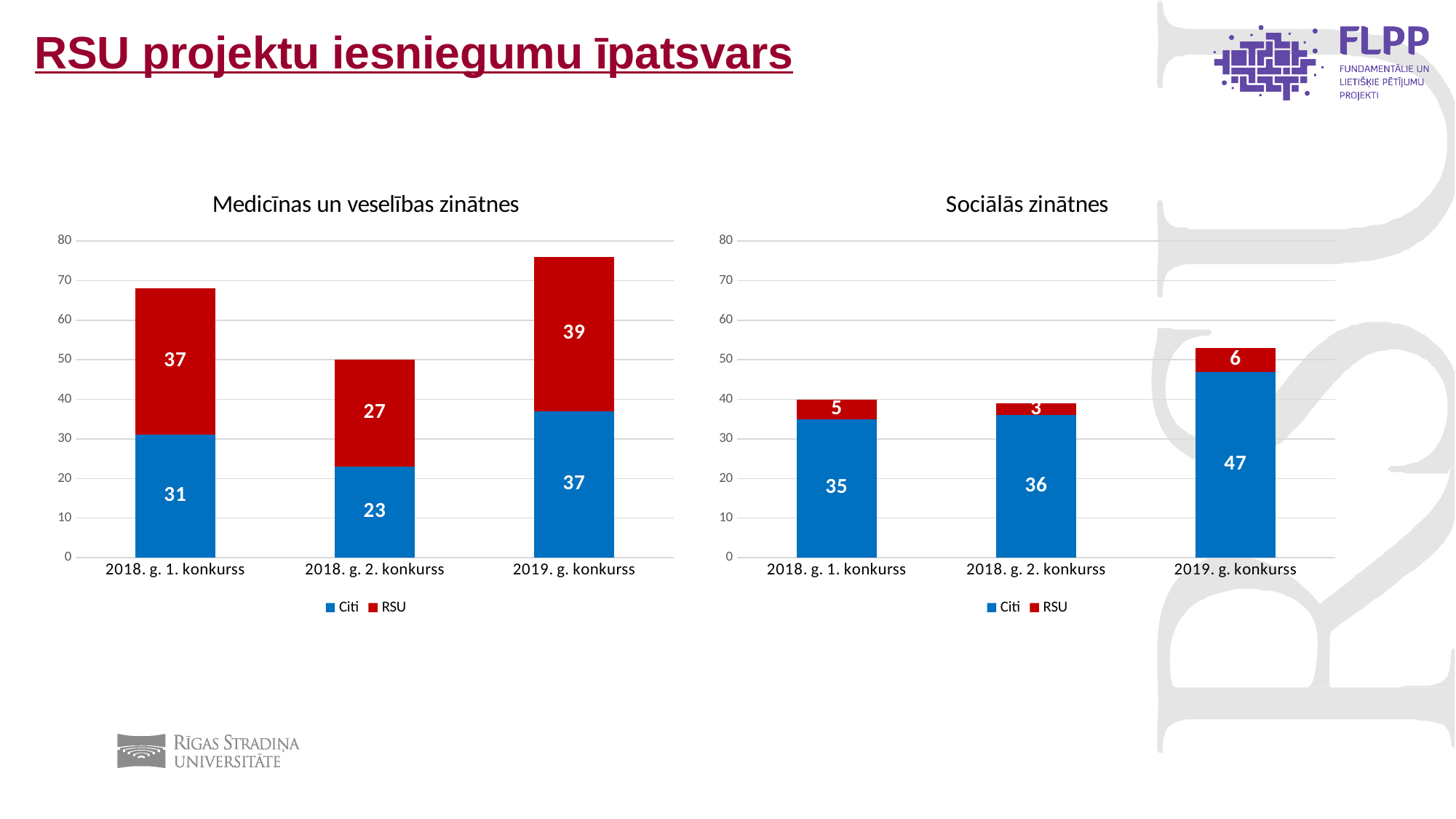
In the 'Sociālās zinātnes' chart, is the Citi value for 2018. g. 1. konkurss or 2019. g. konkurss larger? 2019. g. konkurss How many series does the legend of the 'Medicīnas un veselības zinātnes' chart list? 2 In the 'Medicīnas un veselības zinātnes' chart, which category has the highest RSU value? 2019. g. konkurss In the 'Sociālās zinātnes' chart, what is the total of the stacked bar for 2019. g. konkurss? 53 In the 'Medicīnas un veselības zinātnes' chart, what is the difference between the RSU values for 2019. g. konkurss and 2018. g. 2. konkurss? 12 How many categories are shown on the x axis of the 'Sociālās zinātnes' chart? 3 In the 'Sociālās zinātnes' chart, which category has the lowest RSU value? 2018. g. 2. konkurss In the 'Sociālās zinātnes' chart, what is the Citi value for 2019. g. konkurss? 47 In the 'Medicīnas un veselības zinātnes' chart, what is the RSU value for 2018. g. 1. konkurss? 37 What kind of chart is the 'Sociālās zinātnes' chart? Stacked bar chart In the 'Sociālās zinātnes' chart, which colour represents the RSU series? Red In the 'Medicīnas un veselības zinātnes' chart, what is the total of the stacked bar for 2018. g. 2. konkurss? 50